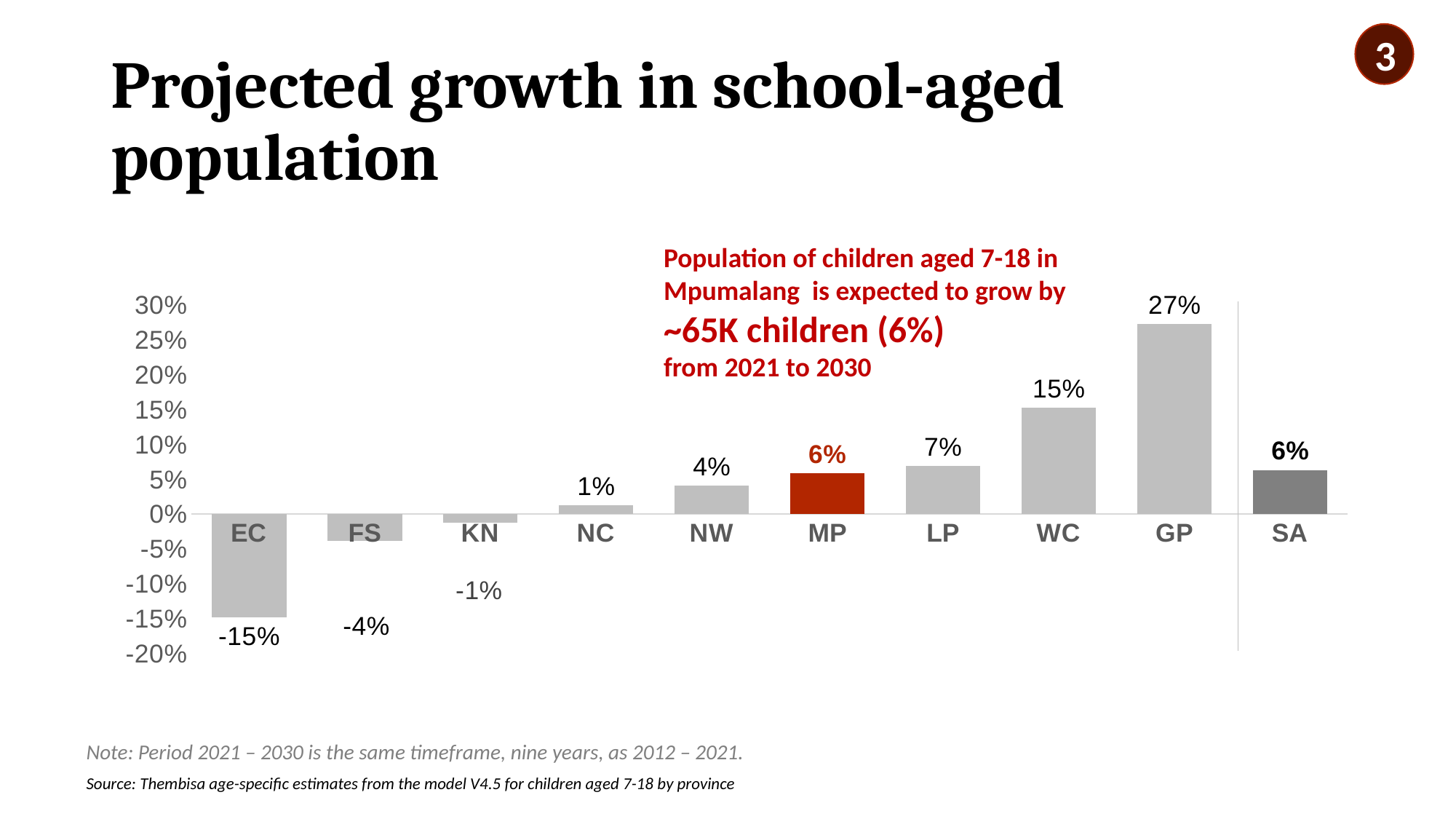
Which has a larger projected growth, LP or NW? LP What is the difference between the values for GP and WC? 12% Which province has the highest projected growth? GP What is the projected growth value for WC? 15% What is the difference between the values for FS and KN? 3% What is the projected growth value for MP? 6% How many categories are shown on the x axis? 10 Which bar is highlighted in red? MP What is the projected growth value for EC? -15% What is the value for SA? 6% Which province has the lowest projected growth? EC What kind of chart is shown on the slide? bar chart